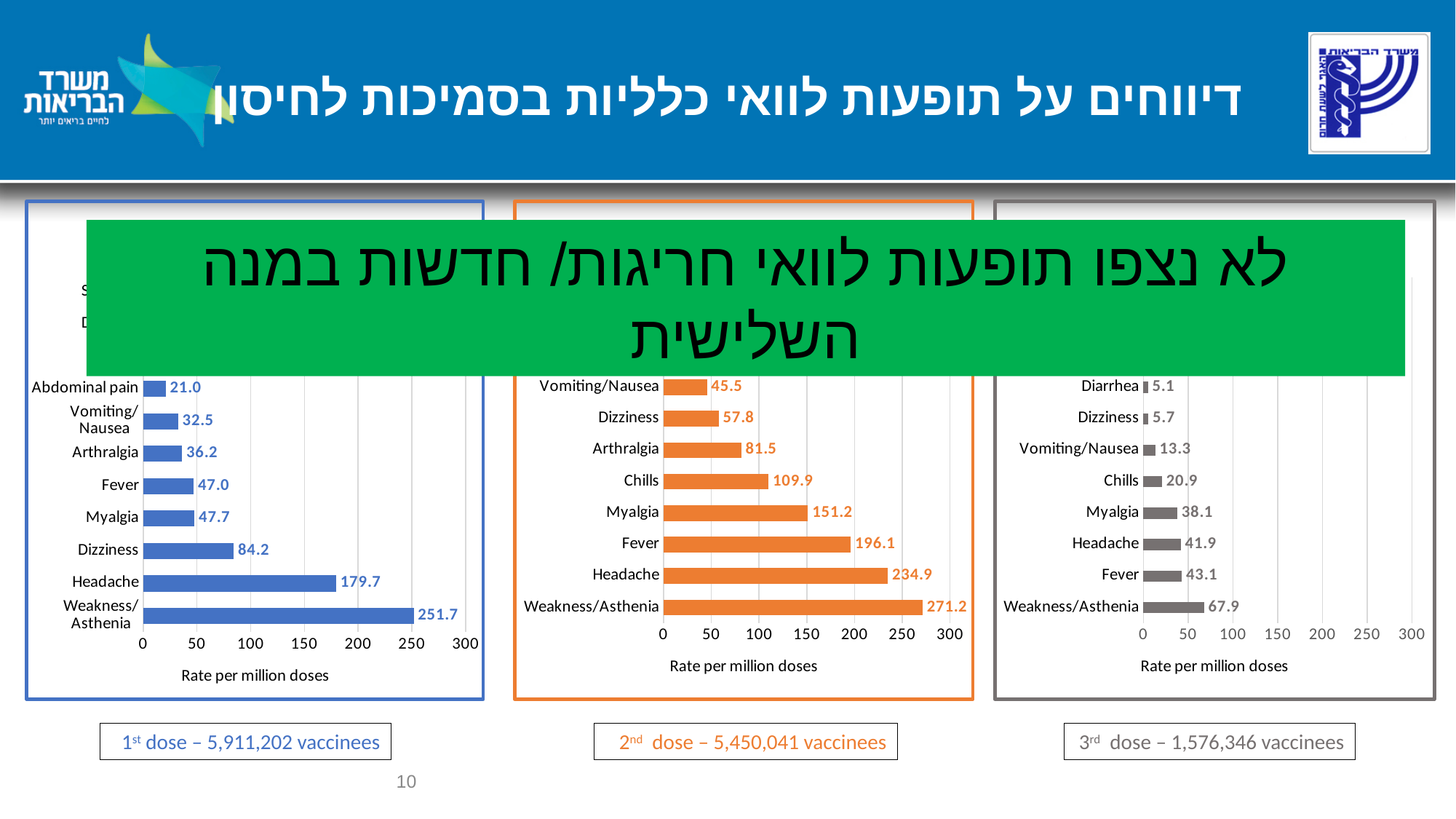
In the right chart (3rd dose), is the value for Weakness/Asthenia greater or less than 50? greater In the left chart (1st dose), what is the rate per million doses for Headache? 179.7 In the right chart (3rd dose), what is the value for Fever? 43.1 In the middle chart (2nd dose), what is the rate per million doses for Chills? 109.9 In the middle chart (2nd dose), which of the visible categories has the highest rate? Weakness/Asthenia According to the label below the right chart, how many vaccinees received the 3rd dose? 1,576,346 What type of chart is used in the middle panel (2nd dose)? Bar chart In the left chart (1st dose), what is the value for Abdominal pain? 21.0 In the left chart (1st dose), which is larger, the value for Dizziness or the value for Myalgia? Dizziness What is the x-axis title of the left chart (1st dose)? Rate per million doses In the right chart (3rd dose), which of the visible categories has the lowest rate? Diarrhea In the middle chart (2nd dose), what is the difference between the values for Headache and Fever? 38.8